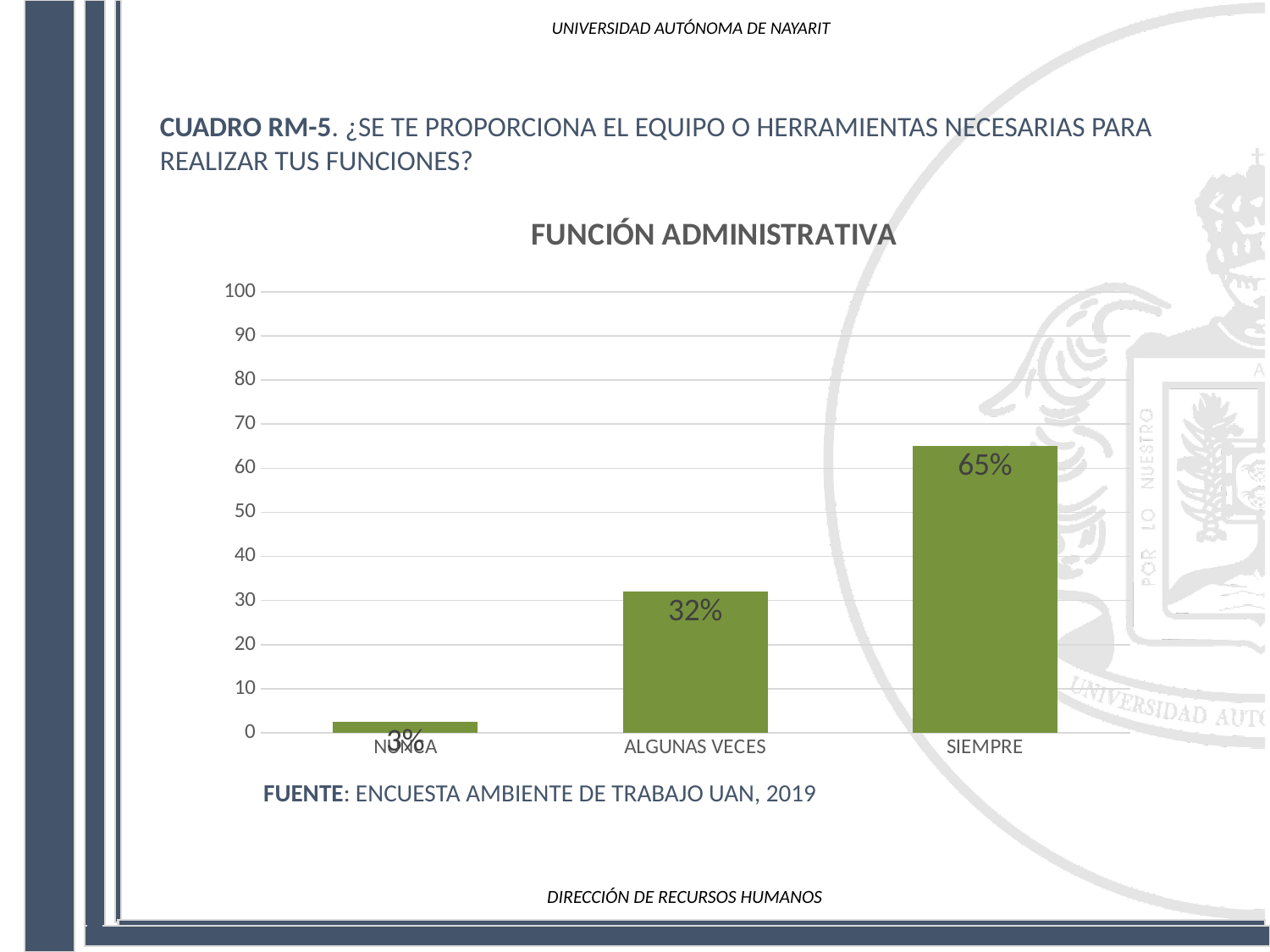
What is the value for ALGUNAS VECES? 32% Is the value for SIEMPRE greater or less than 50? greater Which category has the highest value? SIEMPRE What is the value for NUNCA? 3% What is the value for SIEMPRE? 65% What kind of chart is shown on the slide? bar chart What is the title of the chart? FUNCIÓN ADMINISTRATIVA Which is larger, the value for ALGUNAS VECES or the value for SIEMPRE? SIEMPRE Which category has the lowest value? NUNCA What is the difference between the values for ALGUNAS VECES and NUNCA? 29% How many categories are shown on the x axis? 3 What is the difference between the values for SIEMPRE and ALGUNAS VECES? 33%